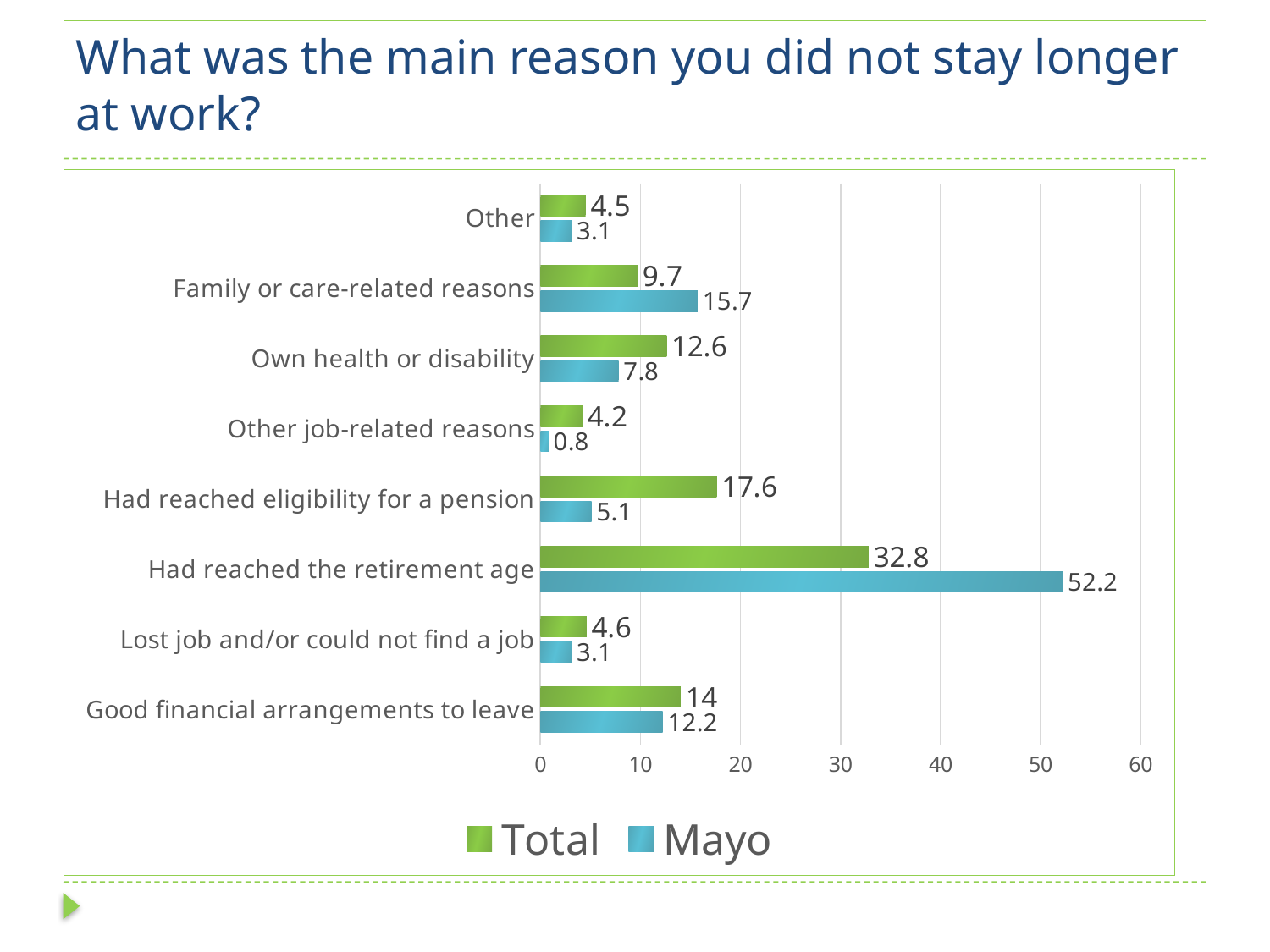
Is the Total value for "Had reached the retirement age" greater or less than 30? greater What is the Mayo value for "Family or care-related reasons"? 15.7 Which series is shown in green in the legend? Total What is the difference between the Mayo and Total values for "Had reached the retirement age"? 19.4 Which category has the highest Total value? Had reached the retirement age What is the Mayo value for "Had reached the retirement age"? 52.2 What kind of chart is shown on the slide? Bar chart What is the Total value for "Had reached eligibility for a pension"? 17.6 How many series does the legend list? 2 For "Own health or disability", which series has the larger value, Total or Mayo? Total How many categories are shown on the chart? 8 Which category has the lowest Mayo value? Other job-related reasons